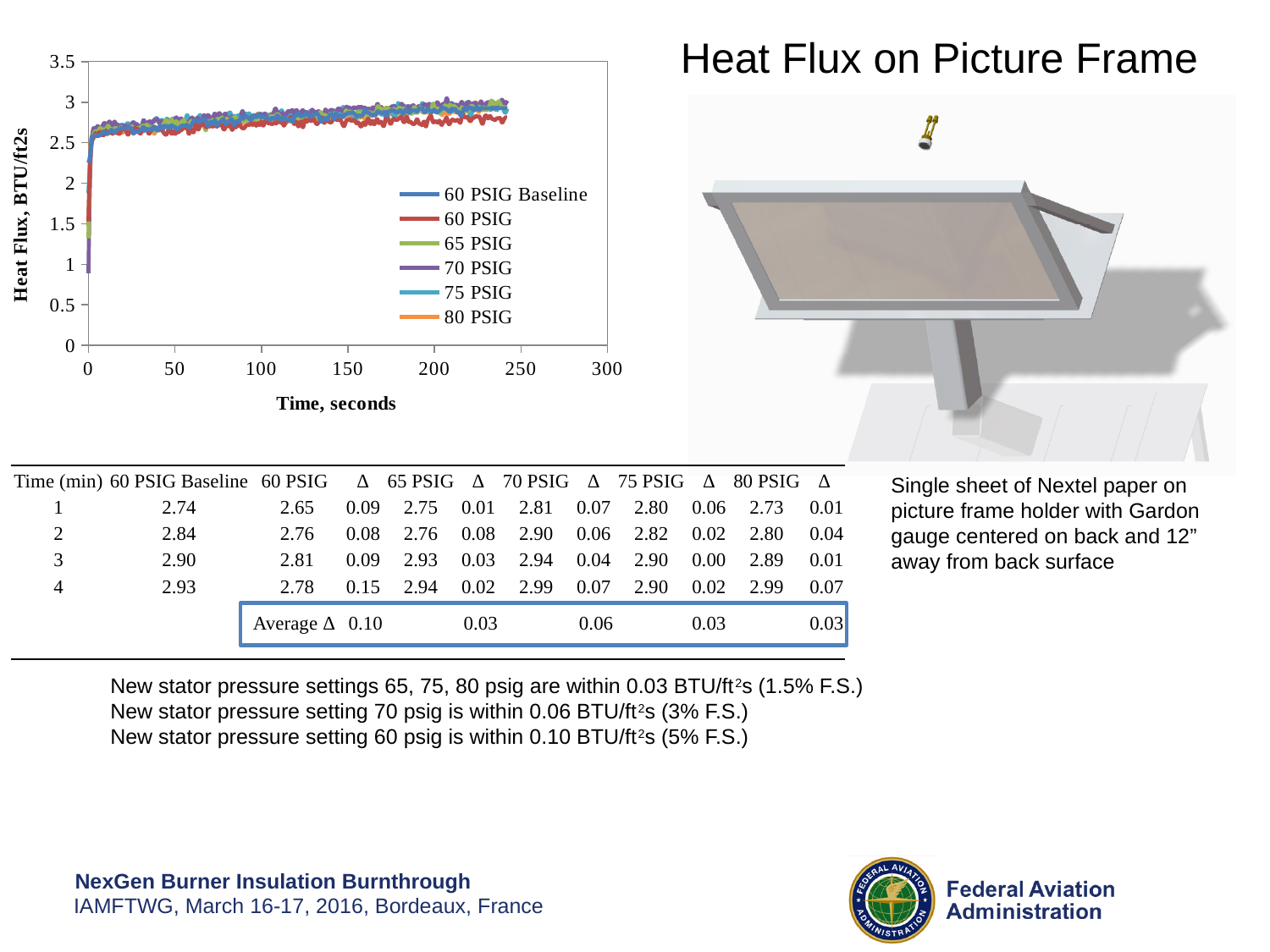
After the initial jump, do the heat flux values rise or fall as time increases along the x axis? rise Which series has the lowest heat flux around 200 seconds? 60 PSIG How many series does the chart's legend list? 6 What is the title of the chart's x axis? Time, seconds What kind of chart is shown on the slide? line chart What is the title of the chart's y axis? Heat Flux, BTU/ft2s Is the value for 75 PSIG at 50 seconds greater or less than 2? greater Is the value for 60 PSIG at 200 seconds greater or less than 3? less Is the value for 60 PSIG at 200 seconds greater or less than 2? greater